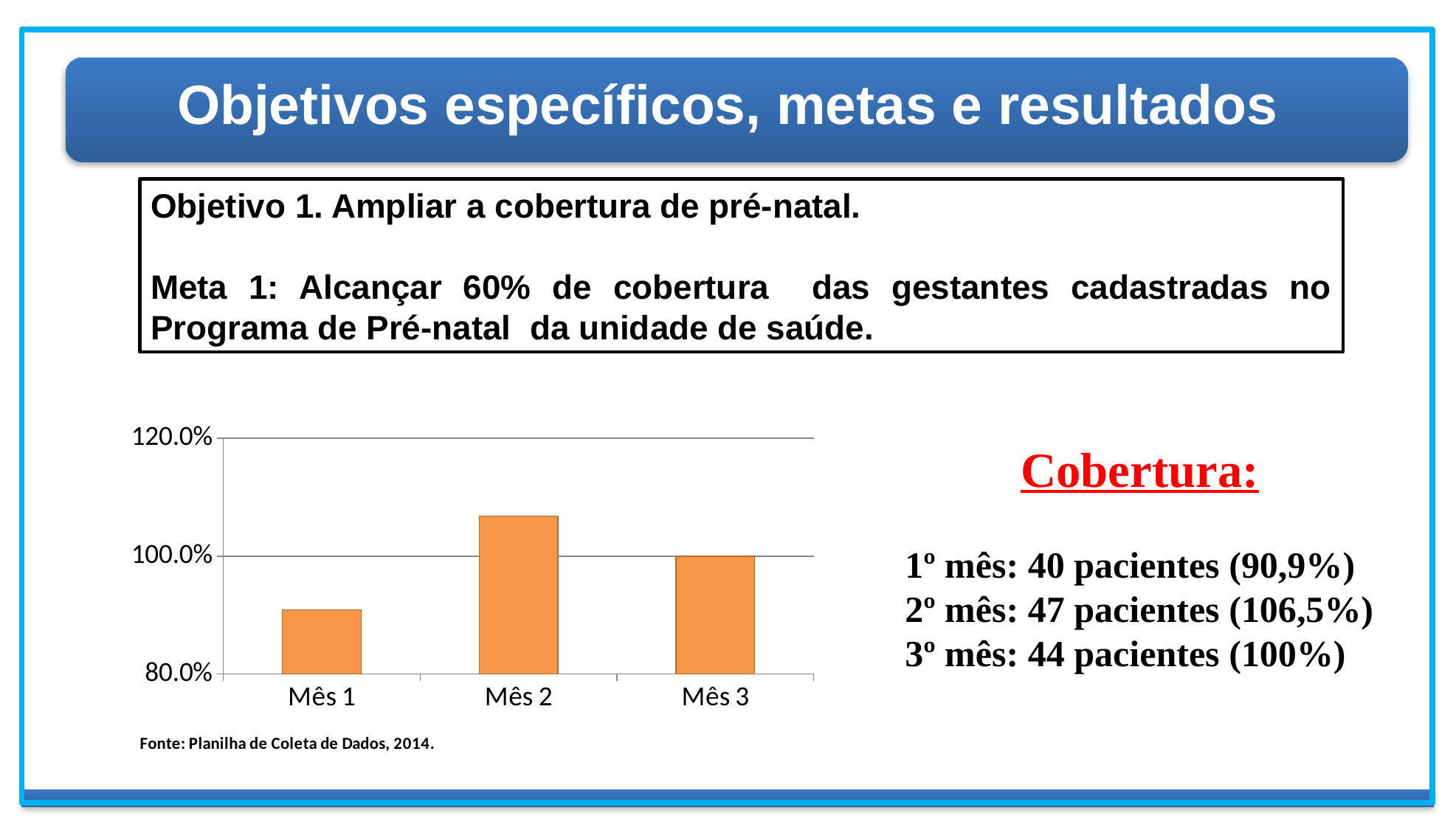
Which month has the lowest bar in the chart? Mês 1 What colour are the bars in the chart? orange What kind of chart is shown on the slide? bar chart Which month has the highest bar in the chart? Mês 2 What is the lowest value shown on the y axis of the chart? 80.0% Do the values rise steadily from Mês 1 to Mês 3? No, they rise from Mês 1 to Mês 2 and then fall at Mês 3 Which is larger, the value for Mês 2 or the value for Mês 3? Mês 2 What value does the bar for Mês 3 reach on the y axis? 100.0% How many categories are shown on the x axis of the chart? 3 Is the value for Mês 1 greater or less than 100.0%? less Is the value for Mês 2 greater or less than 100.0%? greater Which is larger, the value for Mês 1 or the value for Mês 3? Mês 3